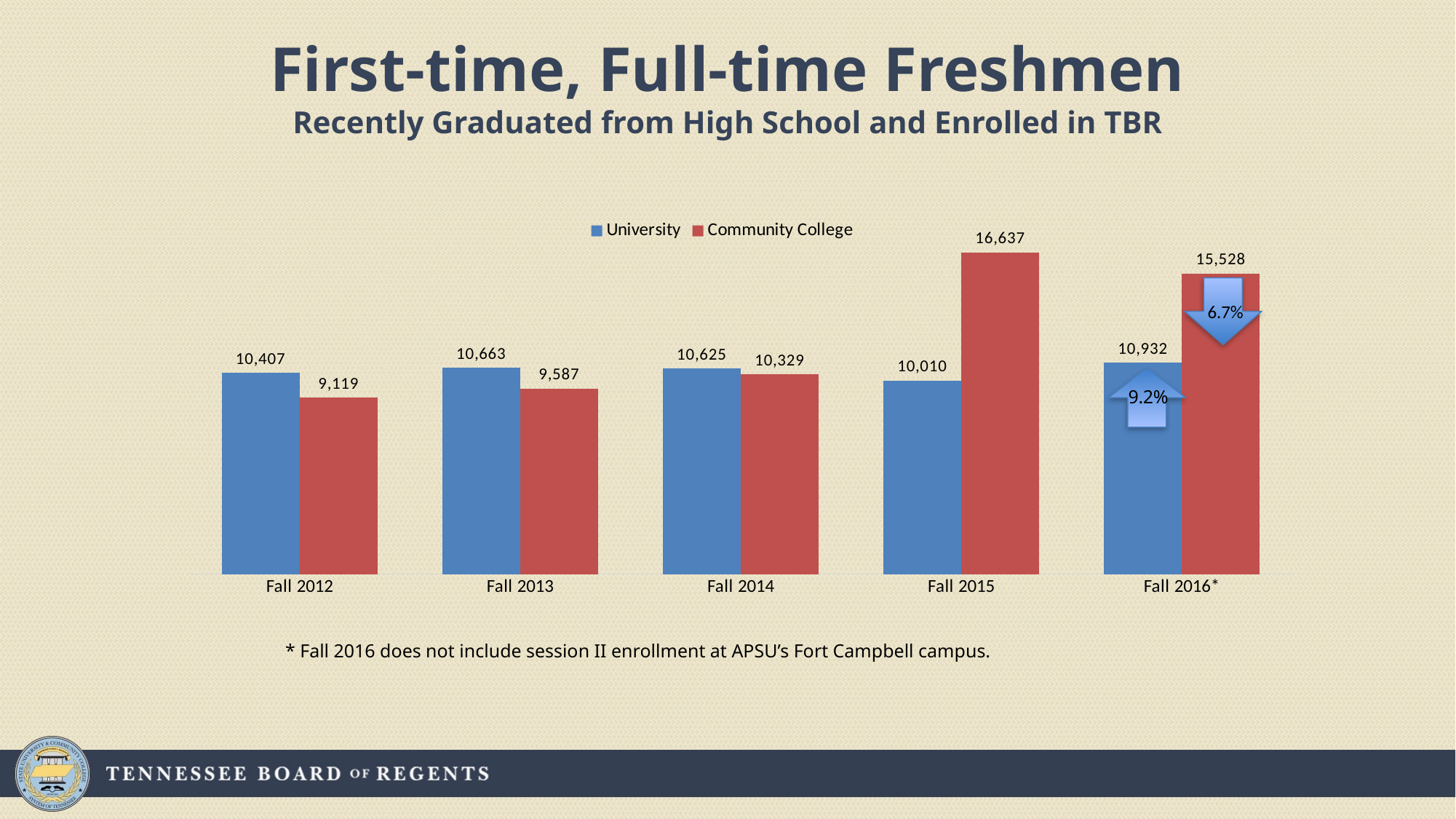
Which year has the lowest Community College value? Fall 2012 What is the difference between the Community College and University values in Fall 2015? 6,627 How many series does the legend list? 2 In Fall 2013, which is larger, the University value or the Community College value? University How many years are shown on the x axis? 5 What is the University value for Fall 2012? 10,407 Which year has the highest Community College value? Fall 2015 What kind of chart is shown on the slide? Bar chart What is the Community College value for Fall 2015? 16,637 What is the Community College value for Fall 2016*? 15,528 Which series is shown in red? Community College Which year has the lowest University value? Fall 2015